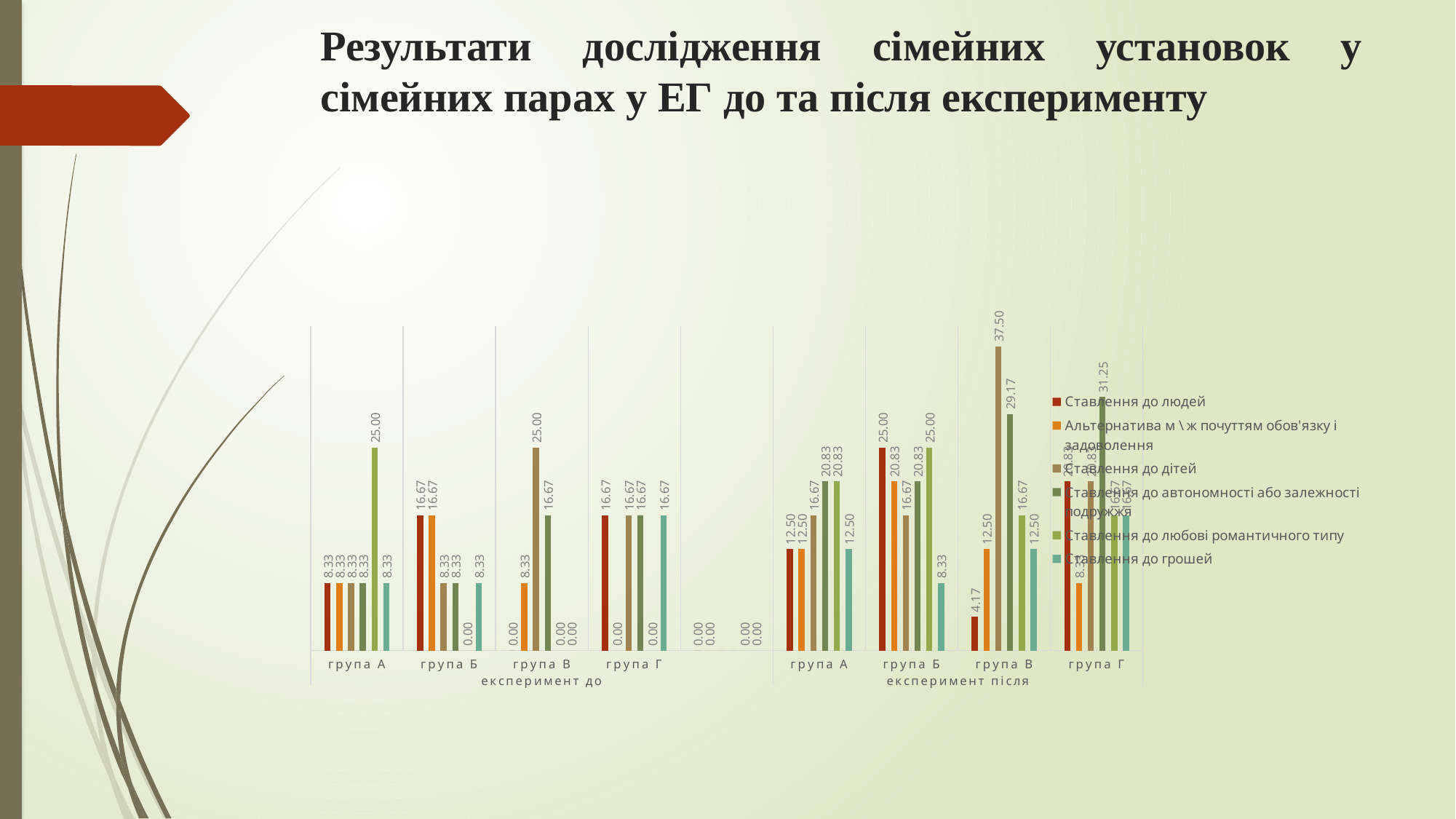
Which series has the highest value for група В in експеримент після? Ставлення до дітей What is the value of Ставлення до людей for група В in експеримент після? 4.17 What is the difference between Ставлення до дітей and Ставлення до автономності або залежності подружжя for група В in експеримент після? 8.33 What is the value of Ставлення до автономності або залежності подружжя for група В in експеримент після? 29.17 What is the value of Ставлення до дітей for група В in експеримент до? 25.00 What is the value of Ставлення до любові романтичного типу for група А in експеримент до? 25.00 What kind of chart is shown on the slide? bar chart What is the value of Ставлення до дітей for група В in експеримент після? 37.50 By how much did Ставлення до людей for група Б change from експеримент до to експеримент після? 8.33 How many series does the chart legend list? 6 What is the value of Ставлення до грошей for група Б in експеримент після? 8.33 Which is larger for Ставлення до людей in експеримент після: група А or група Б? група Б